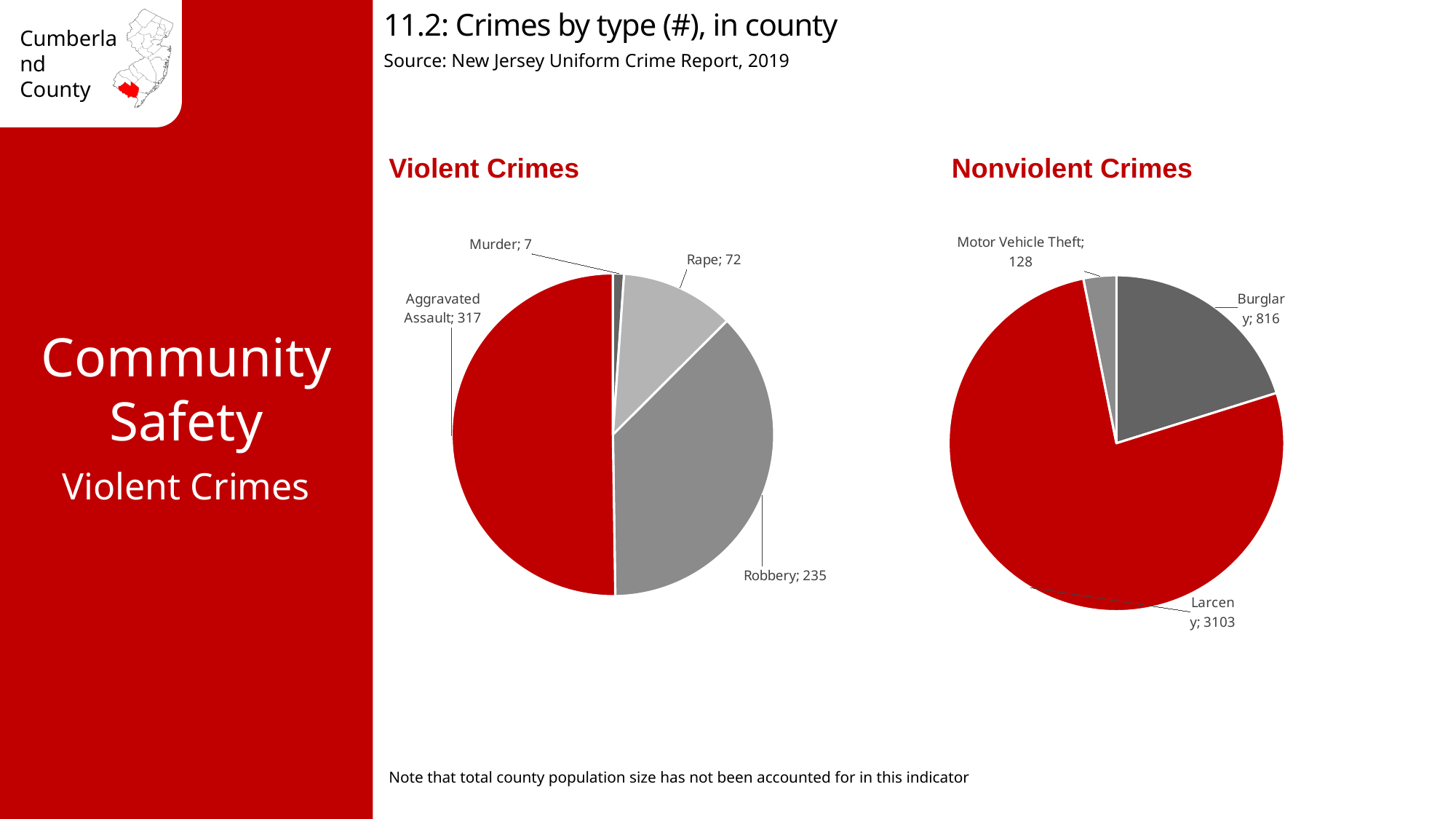
What kind of chart is used for Nonviolent Crimes? Pie chart How many crime types are shown in the Nonviolent Crimes chart? 3 In the Violent Crimes chart, how many robberies are shown? 235 What is the total number of violent crimes across all slices in the Violent Crimes chart? 631 In the Nonviolent Crimes chart, what is the value for Burglary? 816 In the Violent Crimes chart, what is the difference between Aggravated Assault and Robbery? 82 In the Nonviolent Crimes chart, which crime type has the smallest value? Motor Vehicle Theft In the Violent Crimes chart, which crime type has the largest slice? Aggravated Assault In the Violent Crimes chart, which crime type has the smallest slice? Murder How many crime types are shown in the Violent Crimes chart? 4 In the Violent Crimes chart, which is larger, Rape or Robbery? Robbery In the Nonviolent Crimes chart, what is the difference between Larceny and Burglary? 2287